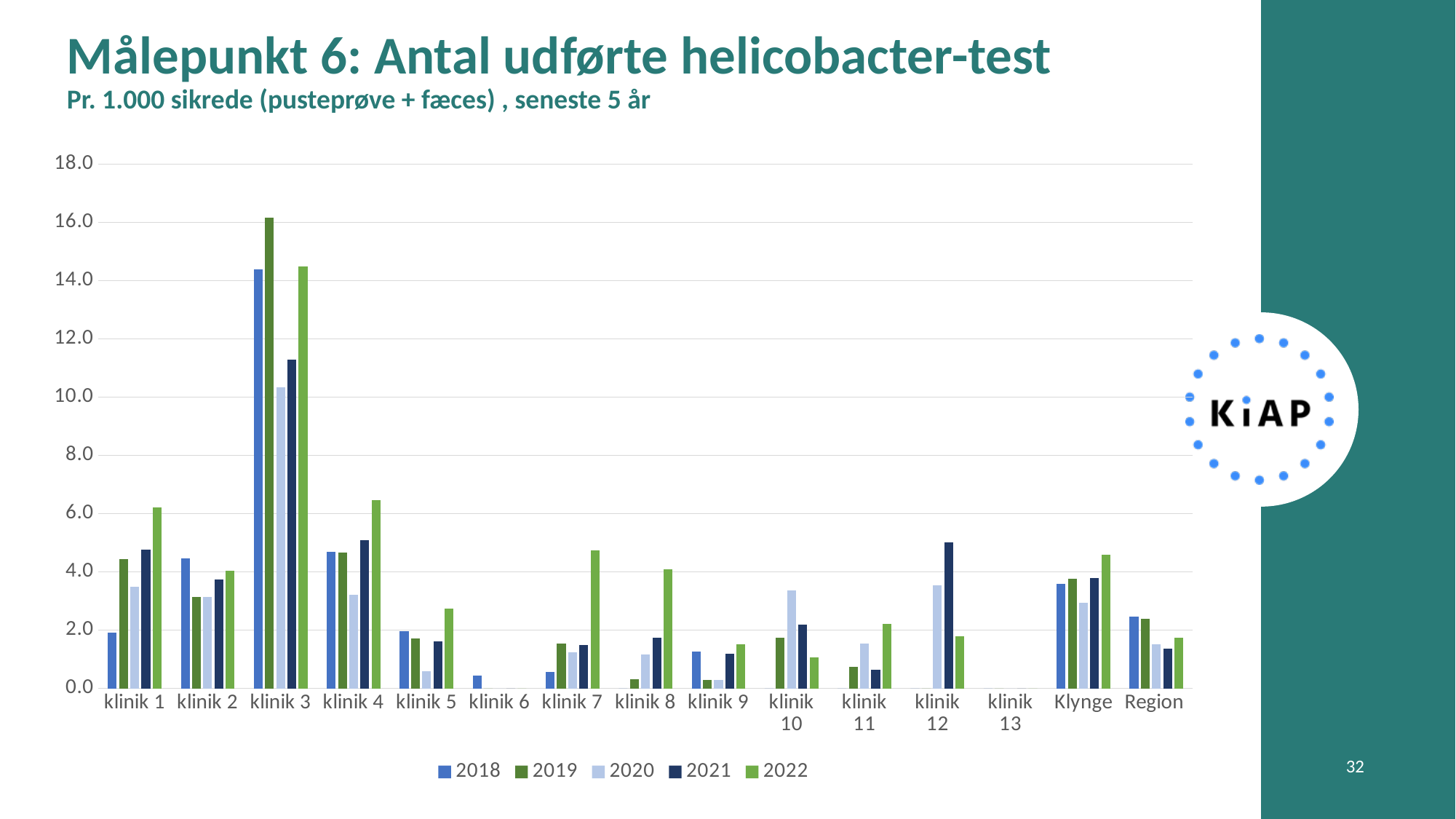
Which has the larger 2022 value: klinik 1 or klinik 2? klinik 1 Is the 2018 value for Region greater or less than 4.0? less Is the 2019 value for klinik 3 greater or less than 14.0? greater Which category has the highest bar in the chart? klinik 3 What is the title of the chart? Målepunkt 6: Antal udførte helicobacter-test Which category has the highest 2022 value? klinik 3 What kind of chart is shown on the slide? bar chart How many categories are shown along the x axis? 15 For klinik 3, which is larger: the 2019 value or the 2022 value? 2019 For klinik 8, which is larger: the 2019 value or the 2022 value? 2022 Is the 2021 value for klinik 12 greater or less than 4.0? greater How many series does the legend list? 5